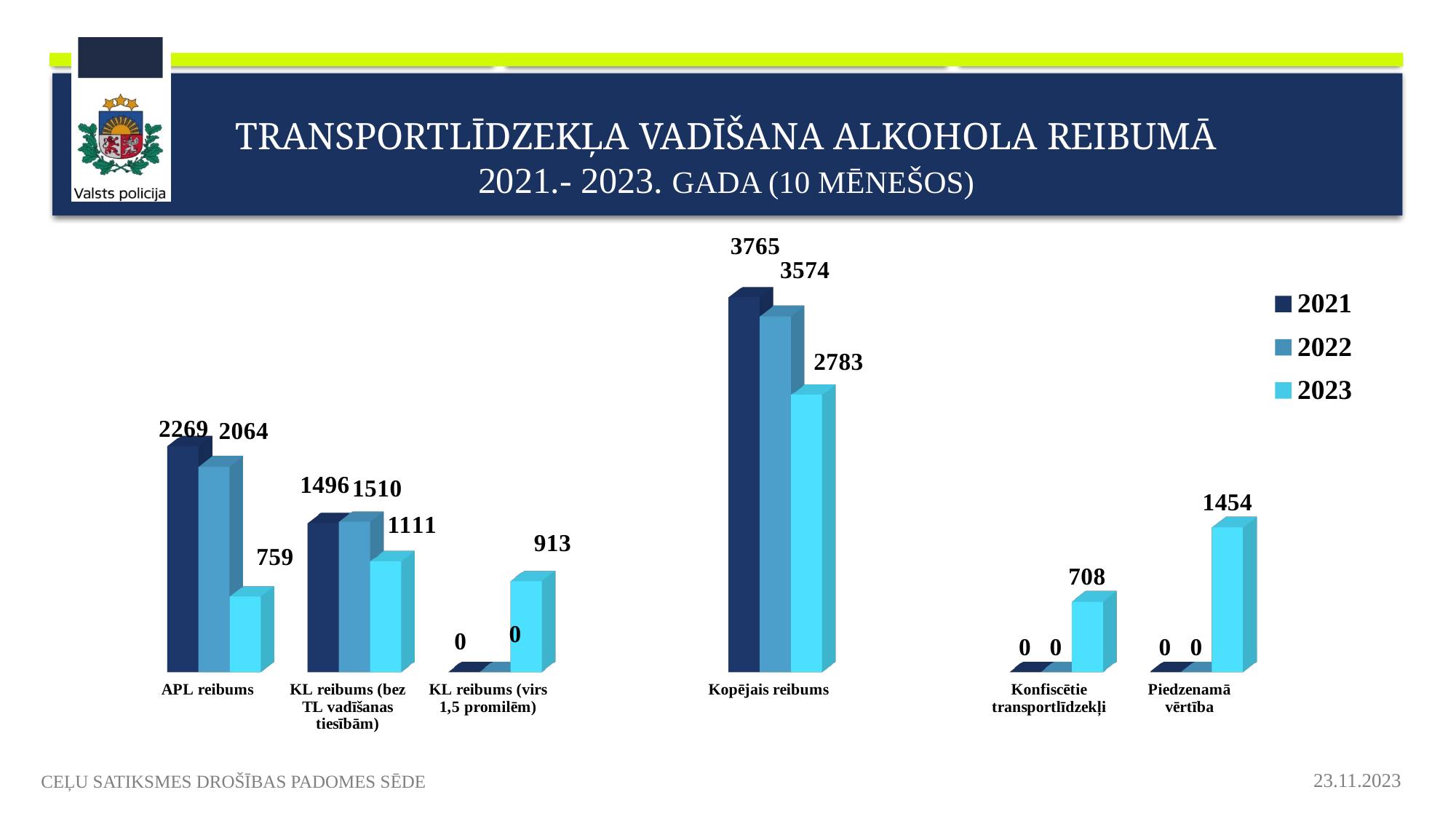
How many series does the legend list? 3 Do the values for APL reibums rise or fall from 2021 to 2023? Fall What is the difference between the 2021 and 2023 values for Kopējais reibums? 982 What kind of chart is shown on the slide? Bar chart Which is larger for KL reibums (bez TL vadīšanas tiesībām): the 2021 value or the 2022 value? 2022 What is the value for KL reibums (bez TL vadīšanas tiesībām) in 2022? 1510 What is the value for APL reibums in 2023? 759 How many categories are shown on the x axis? 6 What is the difference between the 2021 and 2022 values for APL reibums? 205 What is the value for Piedzenamā vērtība in 2023? 1454 Which category has the highest value in 2022? Kopējais reibums What is the value for Kopējais reibums in 2021? 3765